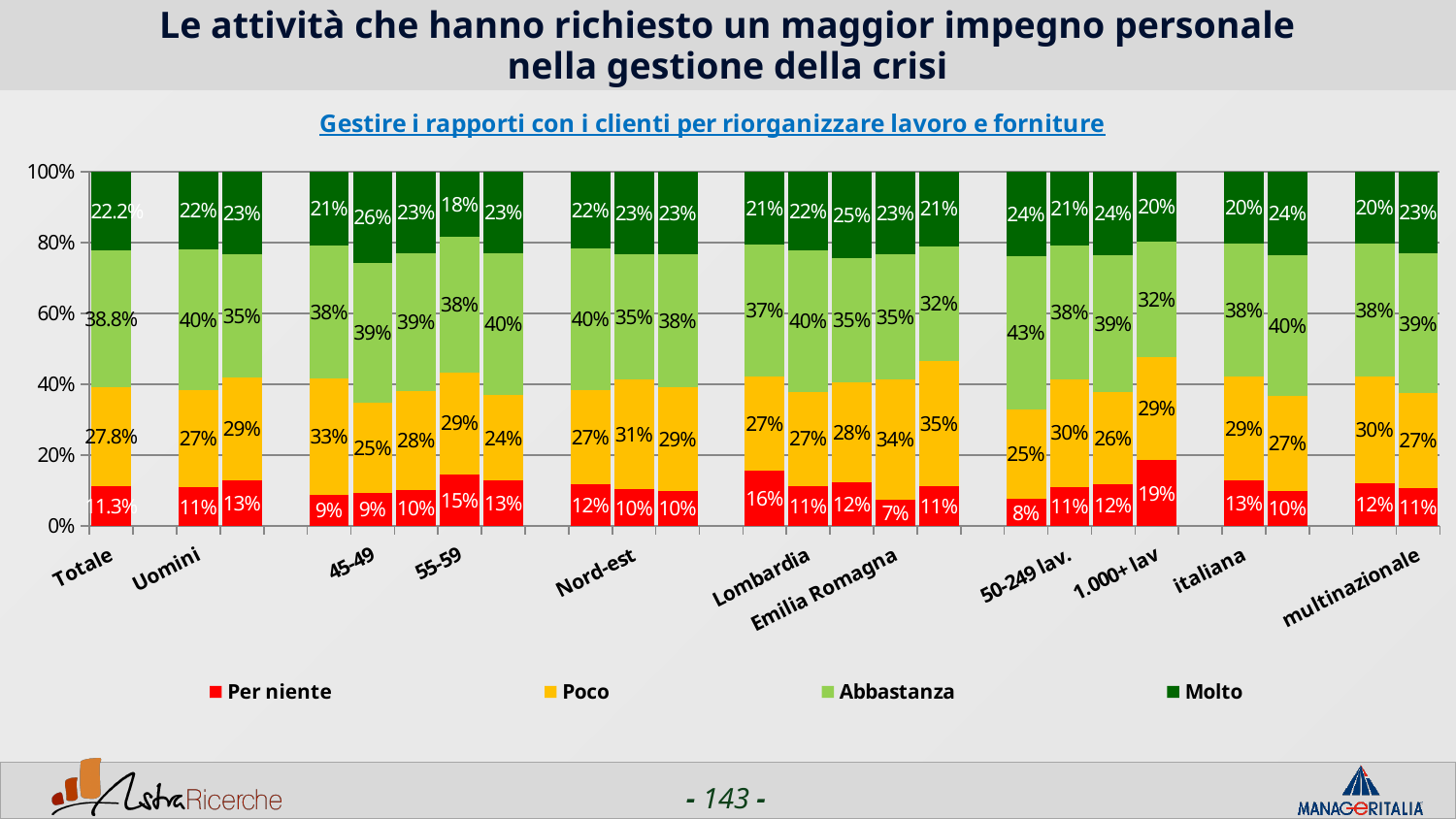
What kind of chart is shown on the slide? Stacked bar chart What are the legend entries of the chart? Per niente, Poco, Abbastanza, Molto What is the 'Per niente' value for Totale? 11.3% For Totale, which series has the largest share? Abbastanza What is the 'Molto' value for Totale? 22.2% For Totale, what is the difference between the 'Abbastanza' and 'Poco' values? 11 percentage points What is the 'Poco' value for Totale? 27.8% What is the 'Per niente' value for Uomini? 11% What is the subtitle shown above the chart? Gestire i rapporti con i clienti per riorganizzare lavoro e forniture How many series does the legend list? 4 What is the 'Abbastanza' value for Totale? 38.8% For Totale, which is larger: 'Abbastanza' or 'Poco'? Abbastanza